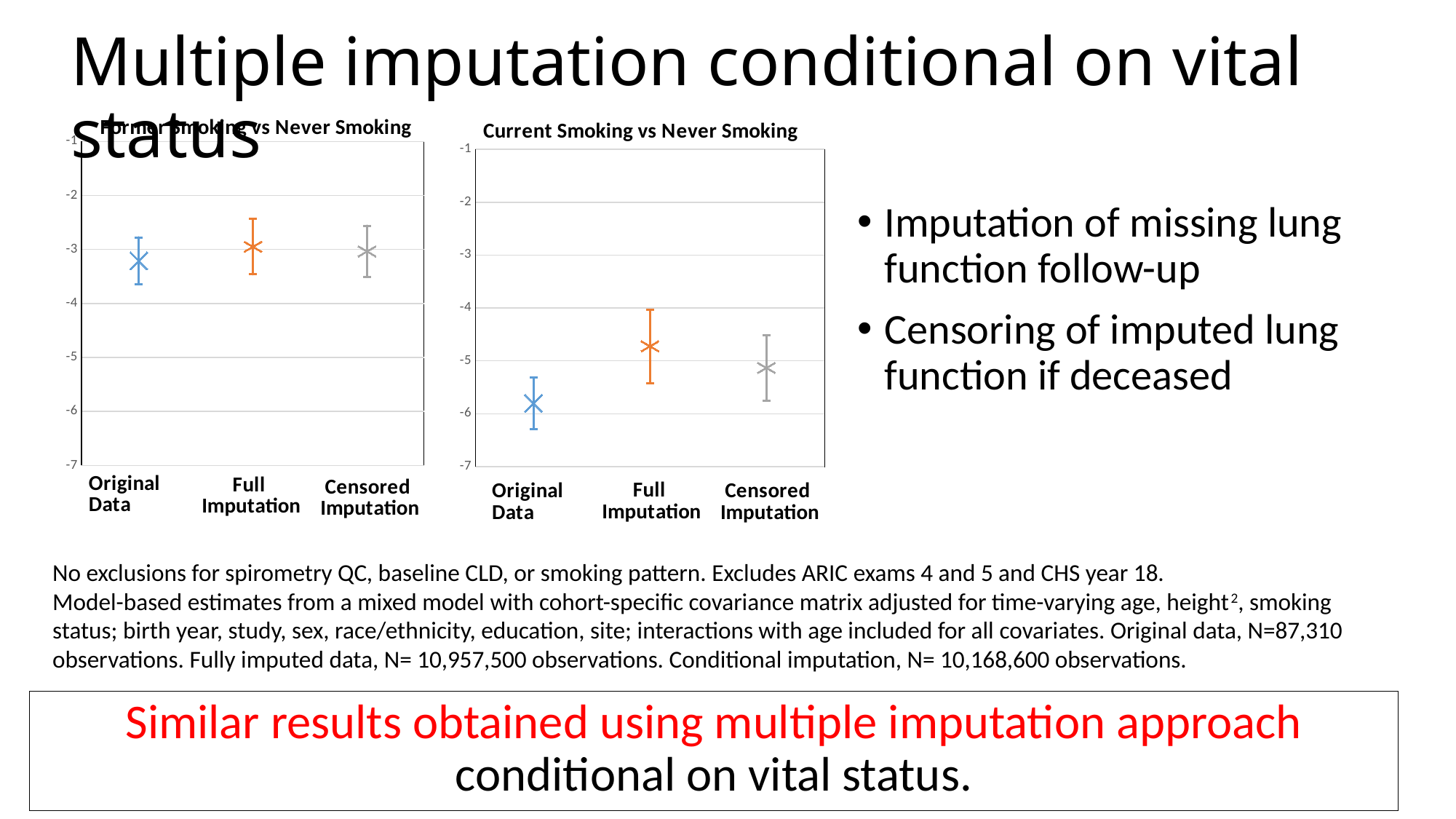
In the 'Current Smoking vs Never Smoking' chart, which category has the highest (least negative) point estimate? Full Imputation What kind of chart is the 'Current Smoking vs Never Smoking' chart? Scatter chart with error bars In the 'Current Smoking vs Never Smoking' chart, what colour is the marker for Full Imputation? Orange In the 'Current Smoking vs Never Smoking' chart, is the point estimate for Original Data greater or less than -5? less In the 'Current Smoking vs Never Smoking' chart, which category has the lowest (most negative) point estimate? Original Data In the 'Current Smoking vs Never Smoking' chart, which is larger, the point estimate for Original Data or for Full Imputation? Full Imputation What is the title of the right-hand chart on the slide? Current Smoking vs Never Smoking In the 'Former Smoking vs Never Smoking' chart, is the point estimate for Original Data greater or less than -3? less How many categories are shown on the x axis of the 'Current Smoking vs Never Smoking' chart? 3 In the 'Current Smoking vs Never Smoking' chart, is the point estimate for Full Imputation greater or less than -5? greater How many categories are shown on the x axis of the 'Former Smoking vs Never Smoking' chart? 3